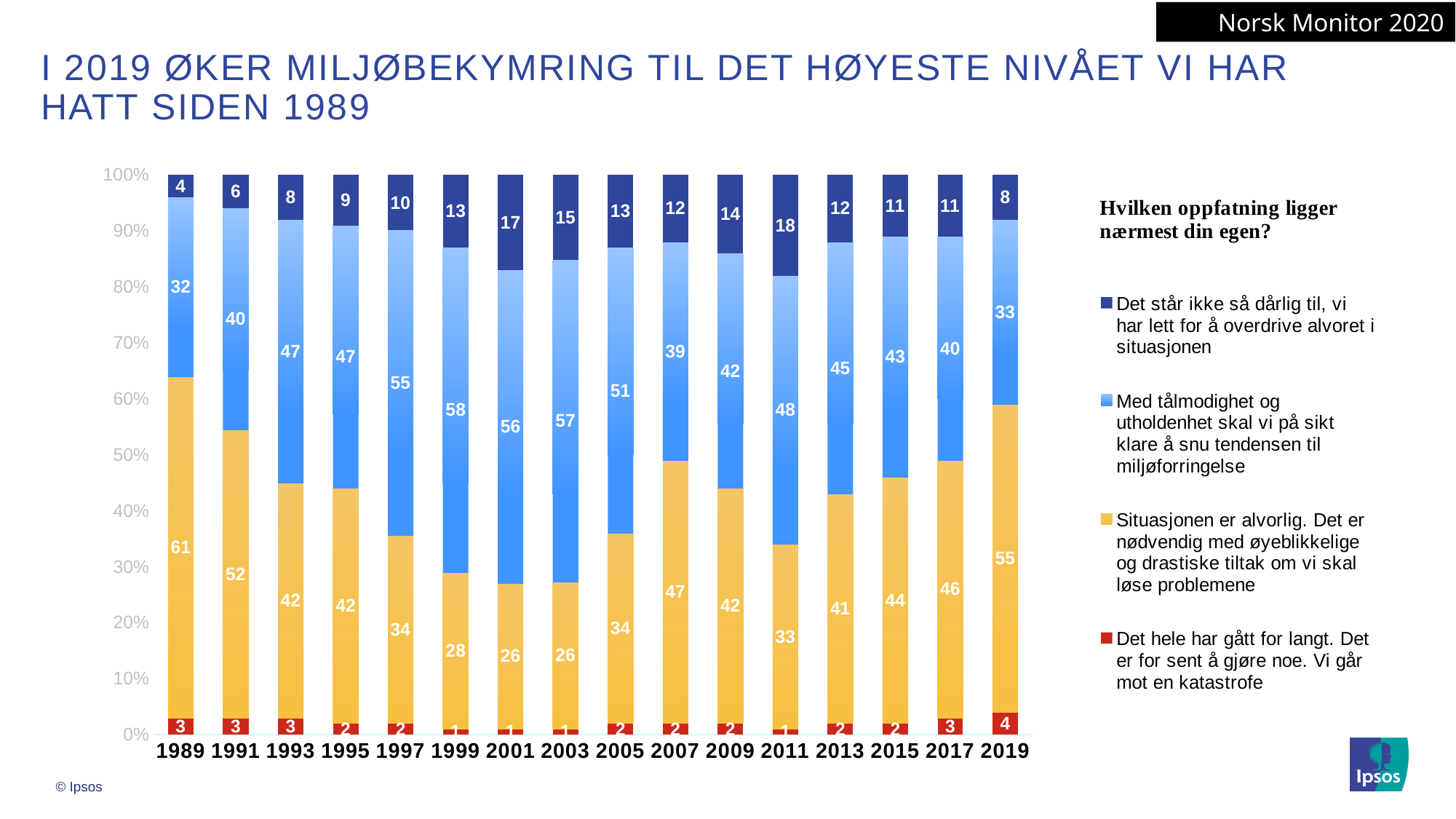
Which is larger in 2007: the "Situasjonen er alvorlig..." value or the "Med tålmodighet og utholdenhet..." value? Situasjonen er alvorlig... In which year is the "Det står ikke så dårlig til..." series lowest? 1989 How many series does the legend list? 4 What is the value for the "Det står ikke så dårlig til..." series in 2011? 18 What is the value for the "Det hele har gått for langt..." series in 2019? 4 What is the difference between the "Situasjonen er alvorlig..." values in 2019 and 2017? 9 What is the value for the "Situasjonen er alvorlig..." series in 2019? 55 In which year is the "Situasjonen er alvorlig..." series highest? 1989 What kind of chart is shown on the slide? Stacked bar chart What is the value for the "Med tålmodighet og utholdenhet..." series in 1999? 58 How many years are shown on the x axis? 16 What is the combined value of the "Det hele har gått for langt..." and "Situasjonen er alvorlig..." series in 1989? 64